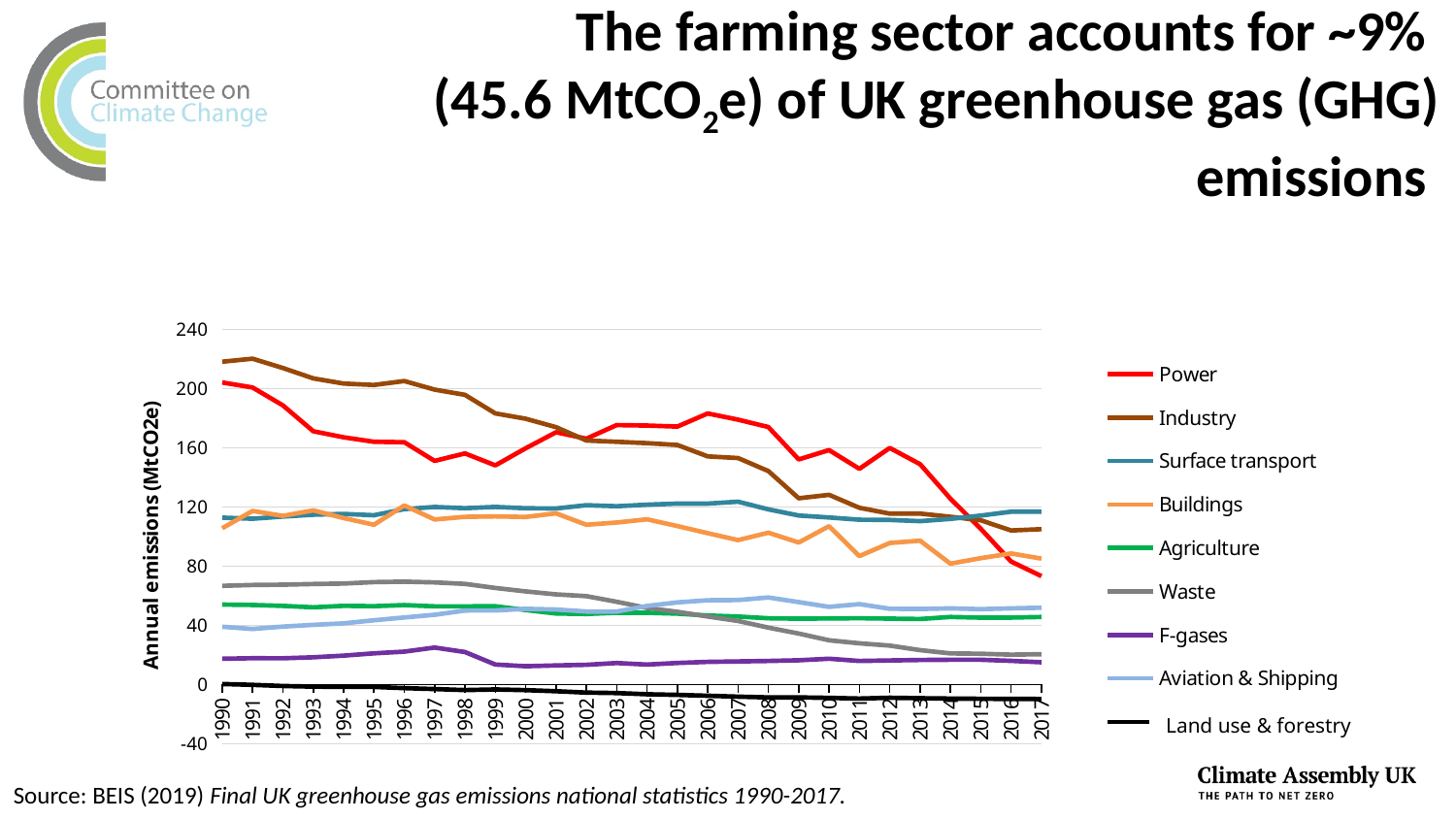
What kind of chart is shown on the slide? line chart How many years are shown along the x axis? 28 In 2017, which is larger, Power or Industry? Industry What is the label on the y axis? Annual emissions (MtCO2e) Is the value for Power in 2017 greater or less than 80? less Do the Power emissions rise or fall from 1990 to 2017? fall Which sector has the highest emissions in 1990? Industry Is the value for Industry in 1990 greater or less than 200? greater Is the value for Waste in 2017 greater or less than 40? less Which sector has the lowest emissions in 2017? Land use & forestry Do the Industry emissions rise or fall from 1990 to 2017? fall How many series does the legend list? 9